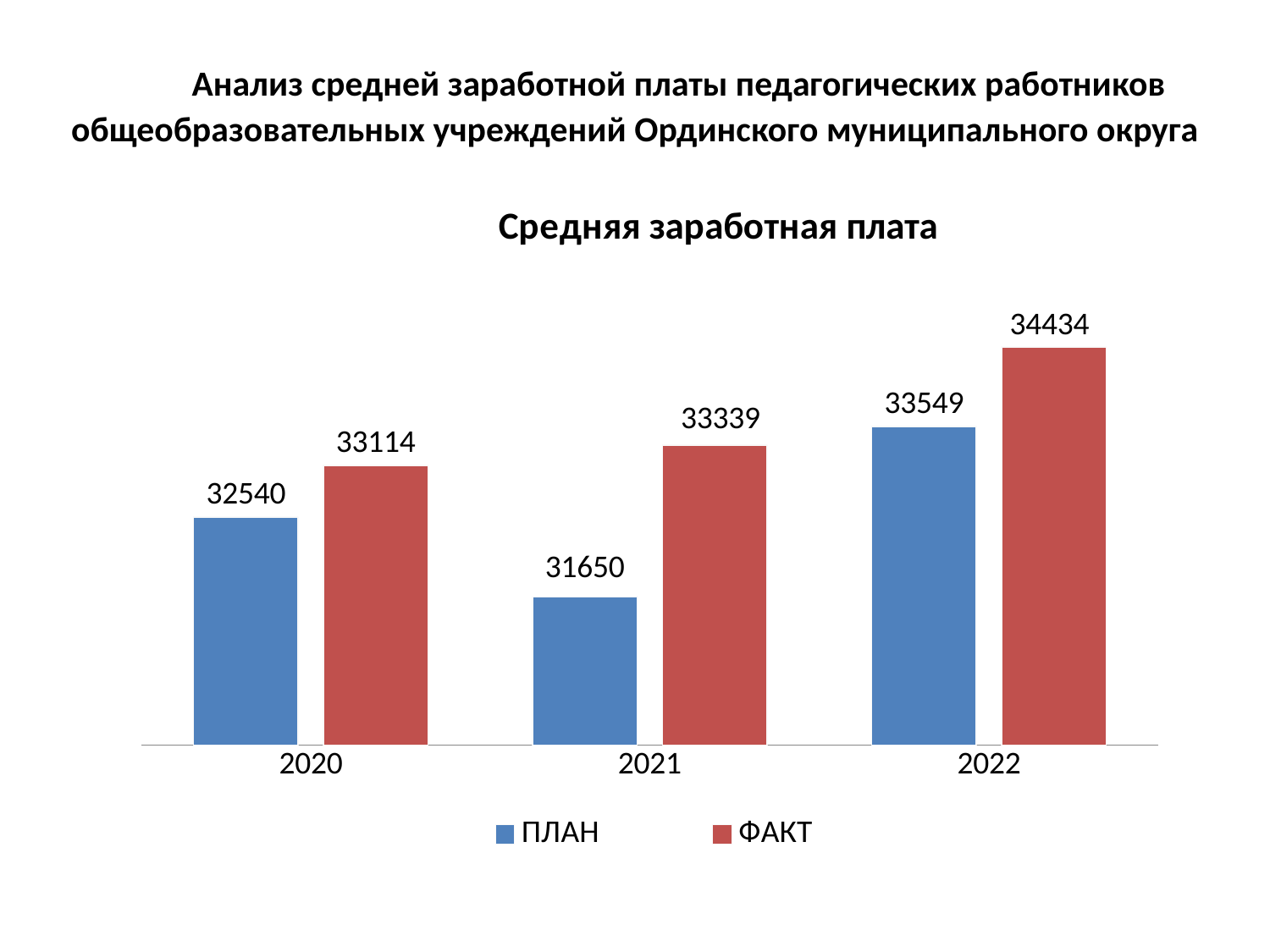
What is the difference between the ФАКТ and ПЛАН values for 2021? 1689 Which year has the lowest ПЛАН value? 2021 What is the ПЛАН value for 2020? 32540 Which year has the highest ФАКТ value? 2022 What is the ФАКТ value for 2021? 33339 What is the difference between the ФАКТ values for 2022 and 2020? 1320 Which is larger, the ПЛАН value for 2022 or the ФАКТ value for 2020? ПЛАН value for 2022 What kind of chart is shown? bar chart How many years are shown on the x axis? 3 What is the title of the chart? Средняя заработная плата How many series does the legend list? 2 What is the ФАКТ value for 2022? 34434